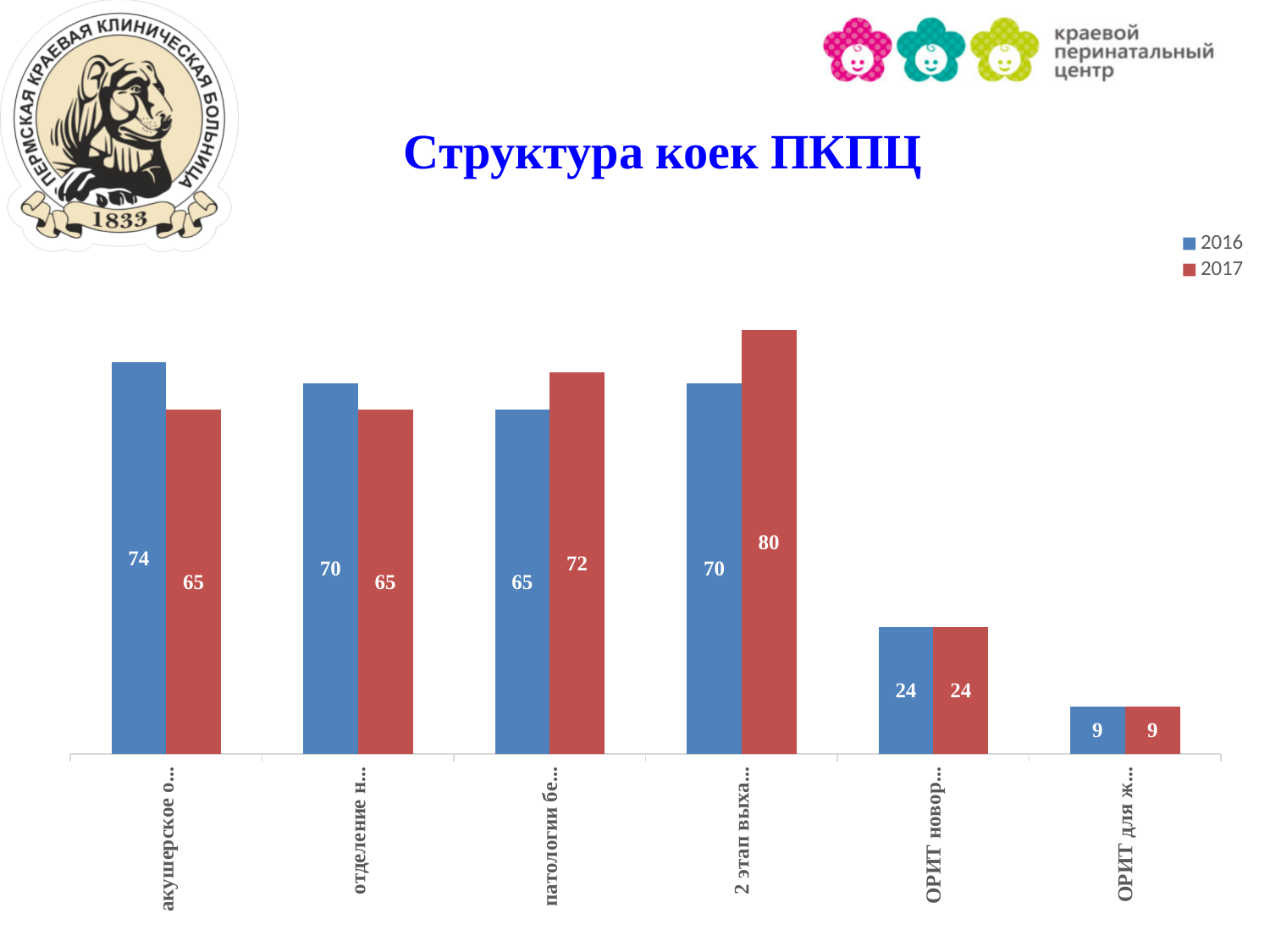
How many series does the legend list? 2 What is the 2016 value for the first category (акушерское о...)? 74 What is the difference between the 2016 and 2017 values for the first category (акушерское о...)? 9 What type of chart is shown on the slide? bar chart Which colour represents the 2017 series? red What is the 2017 value for the fourth category (2 этап выха...)? 80 What is the title of the chart? Структура коек ПКПЦ What is the 2017 value for the third category (патологии бе...)? 72 Which category has the highest 2017 value? 2 этап выха... For the fourth category (2 этап выха...), which is larger, the 2016 value or the 2017 value? 2017 Which category has the lowest 2016 value? ОРИТ для ж... How many categories are shown on the x axis? 6